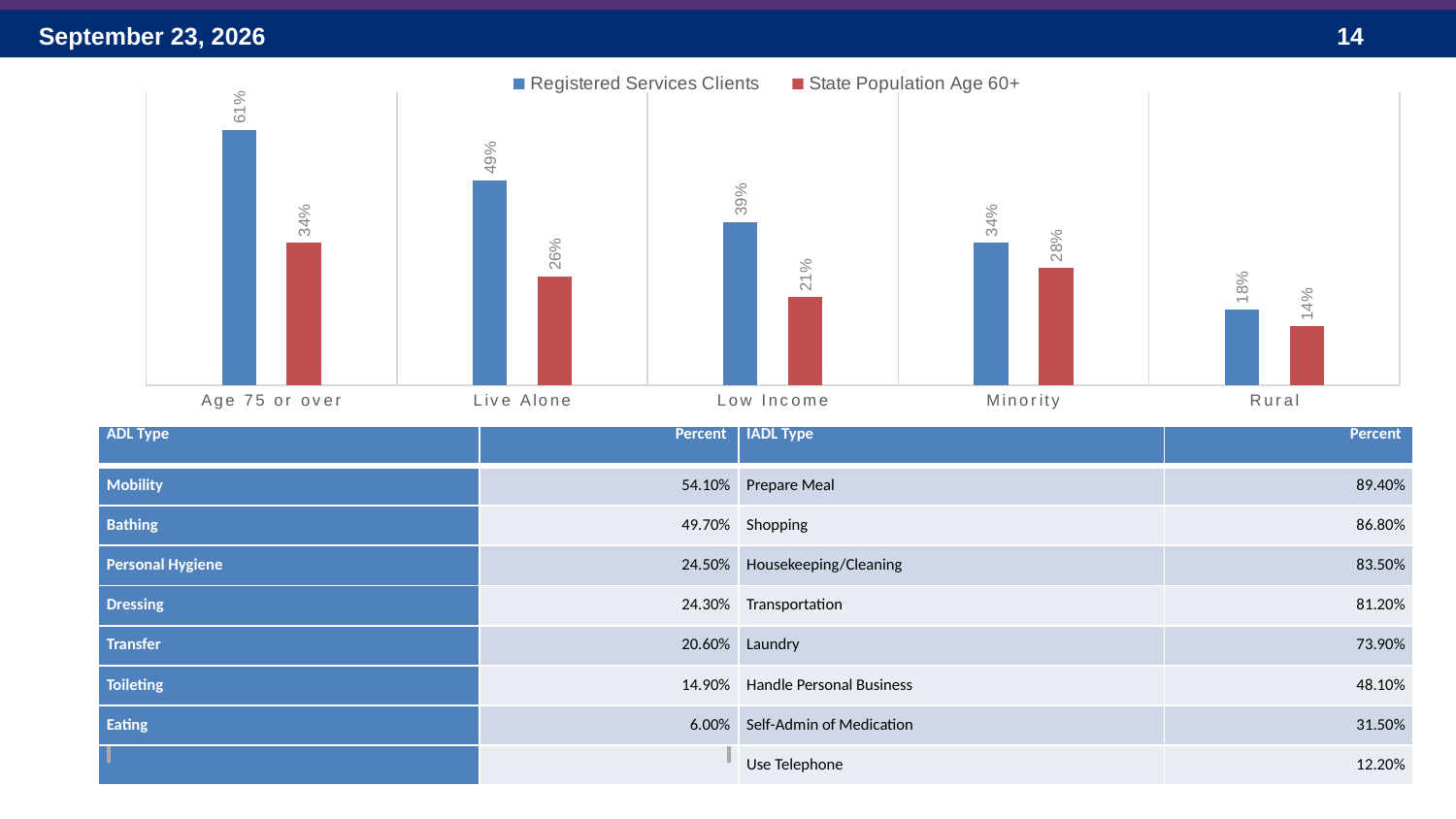
How many categories are shown on the x axis of the chart? 5 What is the value for State Population Age 60+ in the Live Alone category? 26% What is the difference between Registered Services Clients and State Population Age 60+ in the Minority category? 6% Which category has the lowest value for State Population Age 60+? Rural Which category has the highest value for Registered Services Clients? Age 75 or over Which series is shown in red in the chart? State Population Age 60+ What is the value for Registered Services Clients in the Age 75 or over category? 61% Which is larger in the Live Alone category: Registered Services Clients or State Population Age 60+? Registered Services Clients What is the difference between Registered Services Clients and State Population Age 60+ in the Low Income category? 18% How many series does the chart legend list? 2 What is the value for Registered Services Clients in the Rural category? 18% What kind of chart is shown on the slide? Bar chart